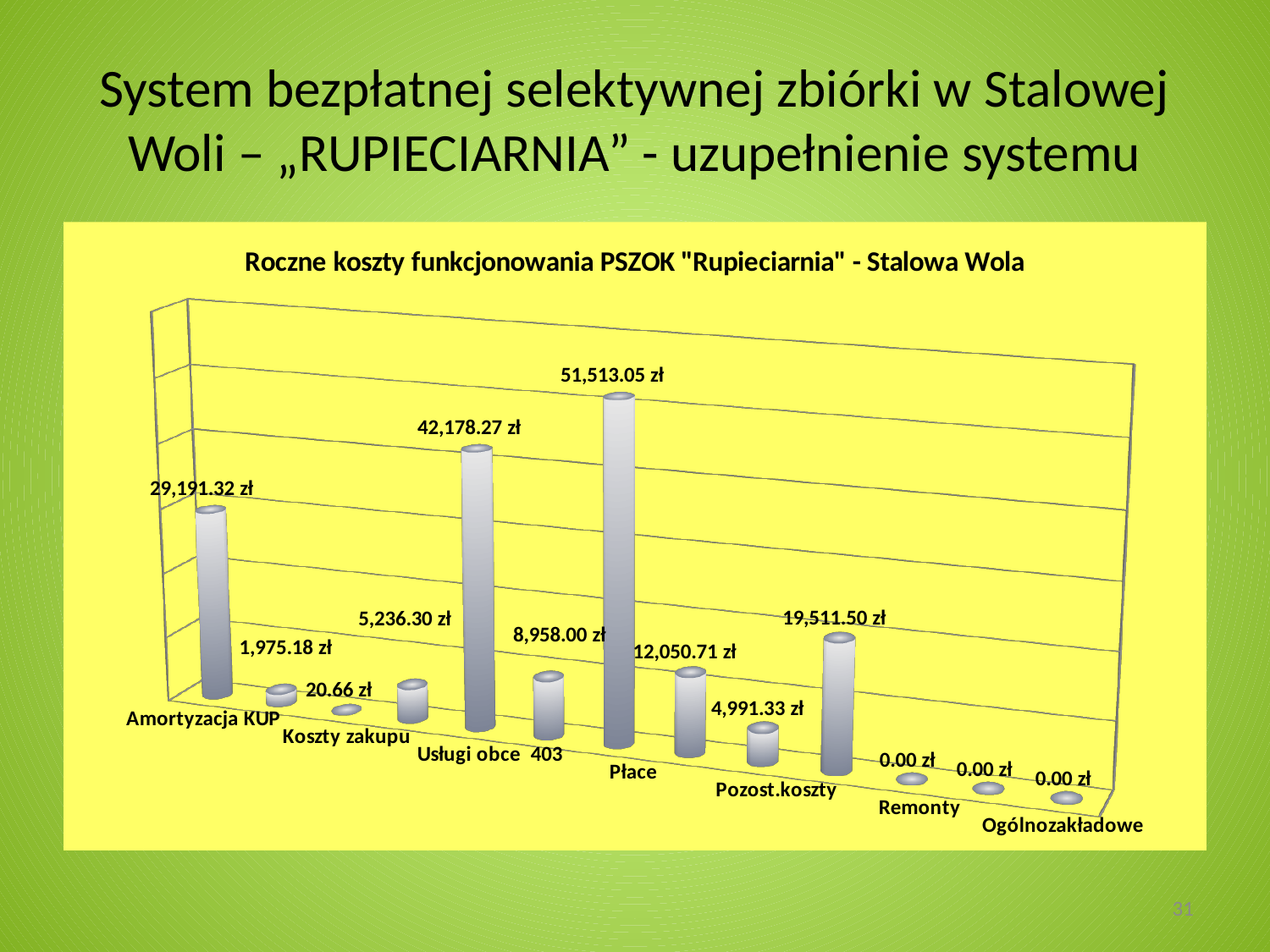
How many bars have a value of 0.00 zł? 3 What is the difference between the value for Amortyzacja KUP (29,191.32 zł) and the bar labelled 19,511.50 zł? 9,679.82 zł What is the title of the chart? Roczne koszty funkcjonowania PSZOK "Rupieciarnia" - Stalowa Wola What kind of chart is shown on the slide? bar chart What is the value for Płace? 51,513.05 zł Which is larger: the value for Płace or the value for Amortyzacja KUP? Płace What is the lowest value shown in the chart? 0.00 zł Which category has the highest value? Płace How many bars are plotted in the chart? 13 What is the value for Amortyzacja KUP? 29,191.32 zł What is the highest value shown in the chart? 51,513.05 zł What is the difference between the highest value (51,513.05 zł) and the second highest value (42,178.27 zł)? 9,334.78 zł